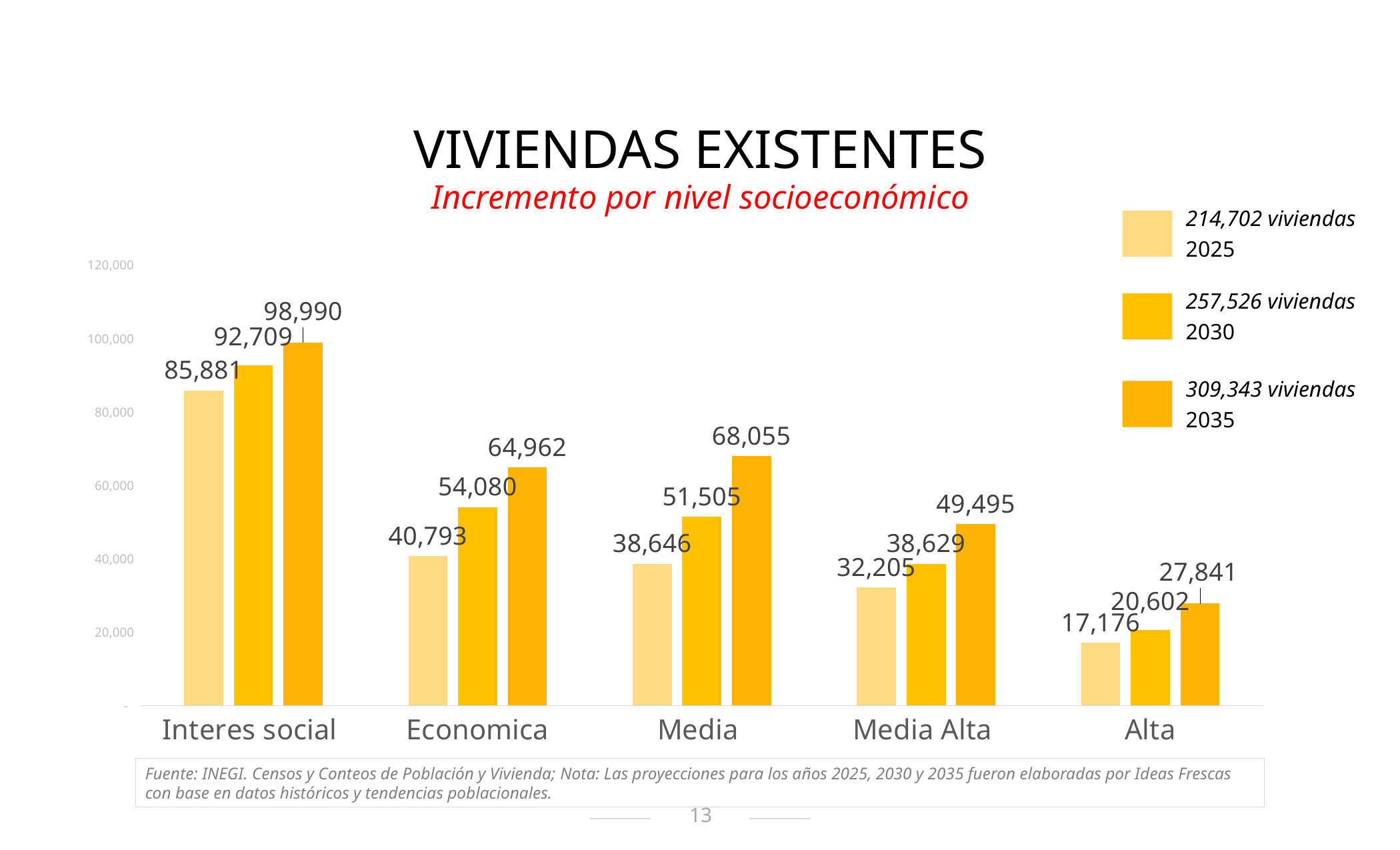
Which category has the highest value in 2035? Interes social What is the value for Alta in 2030? 20,602 What is the difference between the 2035 and 2025 values for Media? 29,409 What is the value for Media in 2025? 38,646 What total number of viviendas does the legend give for 2030? 257,526 viviendas What kind of chart is shown on the slide? Bar chart How many categories are shown on the x axis? 5 Which category has the lowest value in 2025? Alta What is the difference between the 2035 and 2025 values for Interes social? 13,109 What is the value for Interes social in 2035? 98,990 How many series does the legend list? 3 Which is larger: the 2035 value for Economica or the 2035 value for Media? Media